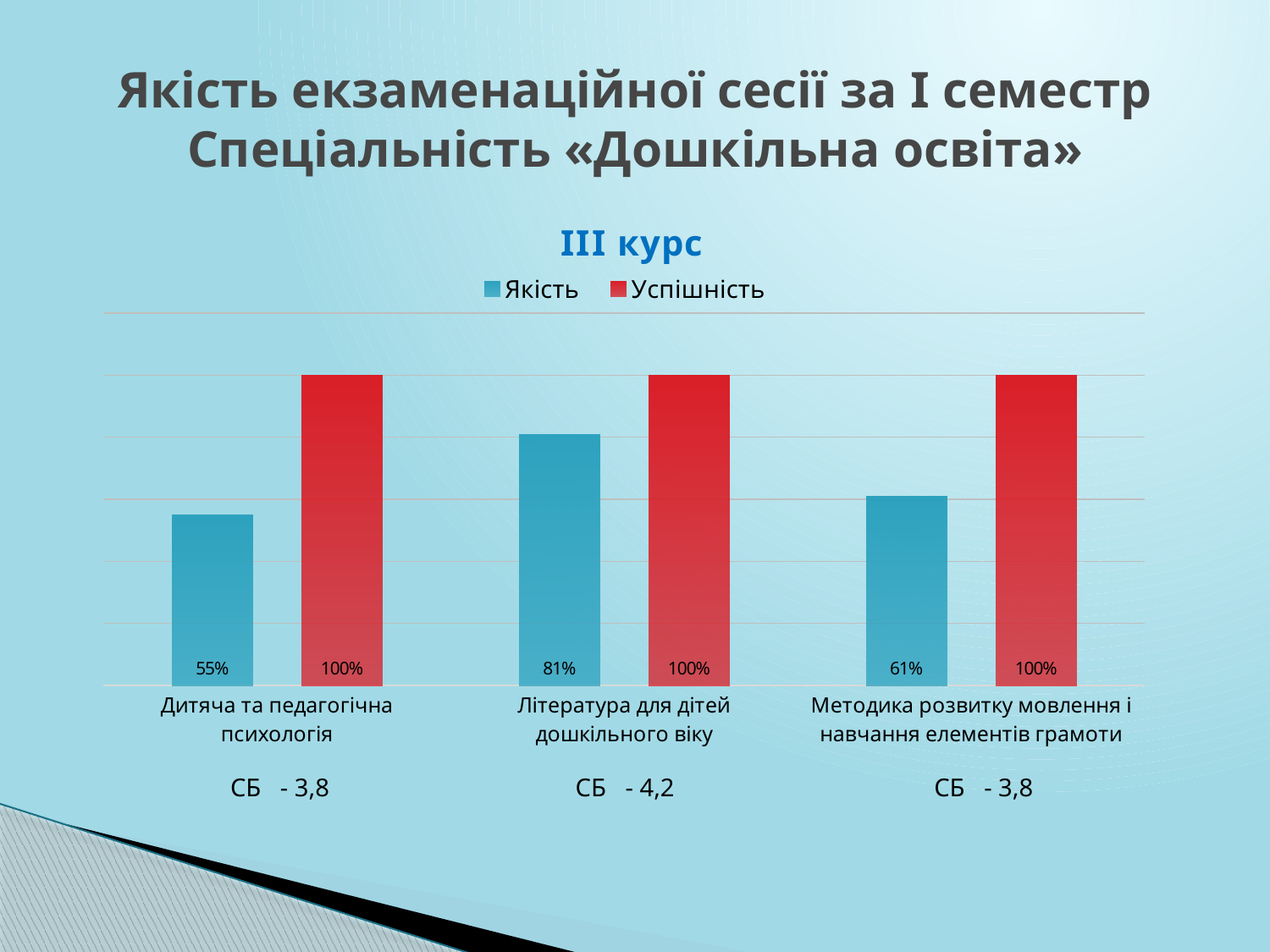
What is the Якість value for Література для дітей дошкільного віку? 81% Which category has the highest Якість value? Література для дітей дошкільного віку What is the difference in Якість between Література для дітей дошкільного віку and Методика розвитку мовлення і навчання елементів грамоти? 20% How many categories are shown on the x axis? 3 How many series does the legend list? 2 Which category has the lowest Якість value? Дитяча та педагогічна психологія What is the difference between the Успішність and Якість values for Дитяча та педагогічна психологія? 45% What is the Якість value for Методика розвитку мовлення і навчання елементів грамоти? 61% What type of chart is shown on the slide? Bar chart What is the Якість value for Дитяча та педагогічна психологія? 55% What is the Успішність value for Література для дітей дошкільного віку? 100% Which is larger: the Якість value for Методика розвитку мовлення і навчання елементів грамоти or for Дитяча та педагогічна психологія? Методика розвитку мовлення і навчання елементів грамоти